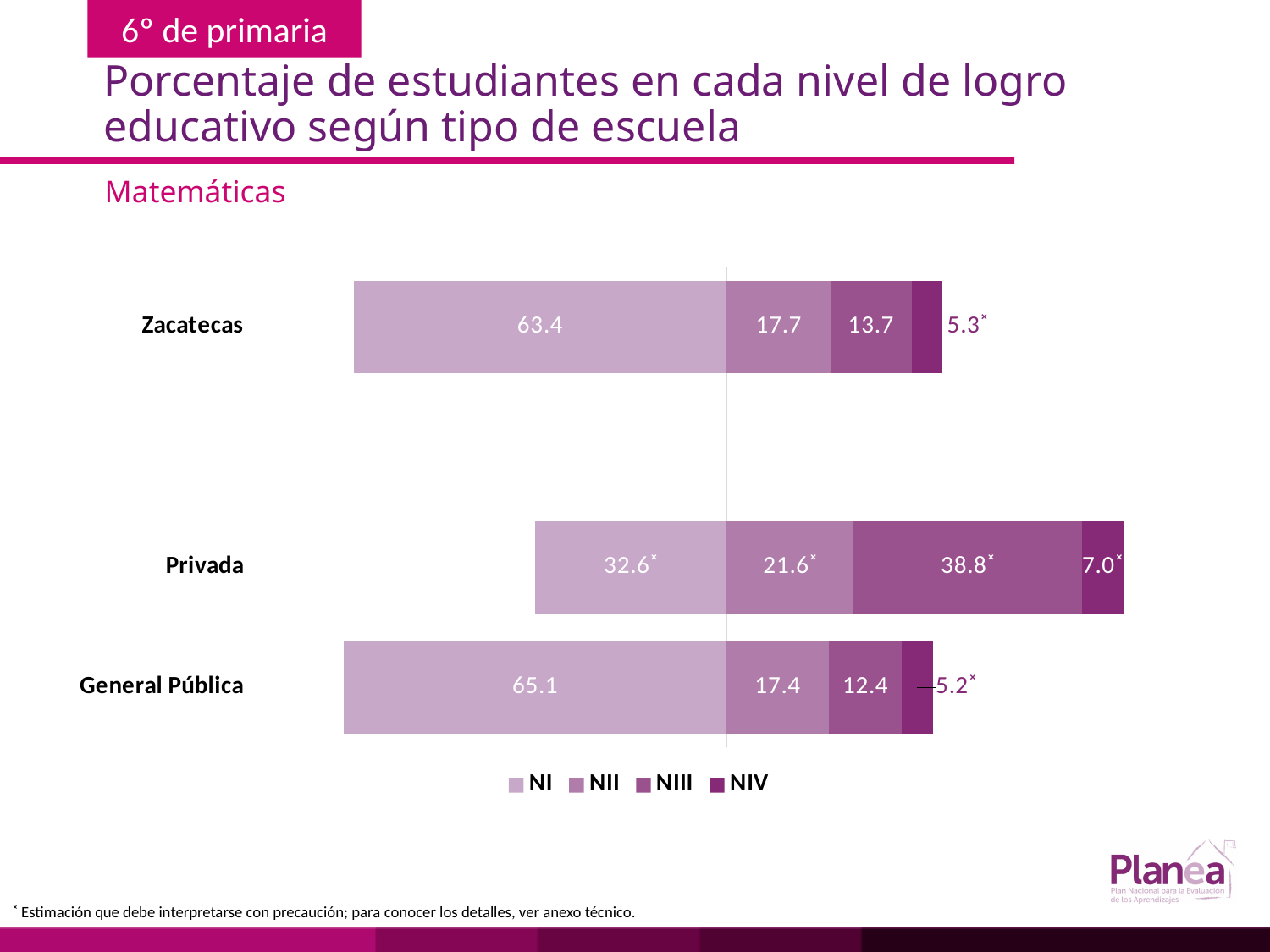
How many school categories are shown in the chart? 3 How many series does the legend list? 4 Which school type has the highest NI percentage? General Pública What is the NIII value for Privada schools? 38.8 What is the difference between the NI values for General Pública and Privada? 32.5 What is the NIV value for Privada? 7.0 What type of chart is shown on the slide? Stacked bar chart What is the total of the stacked bar for Privada? 100.0 Which is larger, the NIII value for Privada or the NIII value for Zacatecas? Privada What percentage of Zacatecas students are at level NI? 63.4 What is the NII value for General Pública? 17.4 Which school type has the lowest NI percentage? Privada